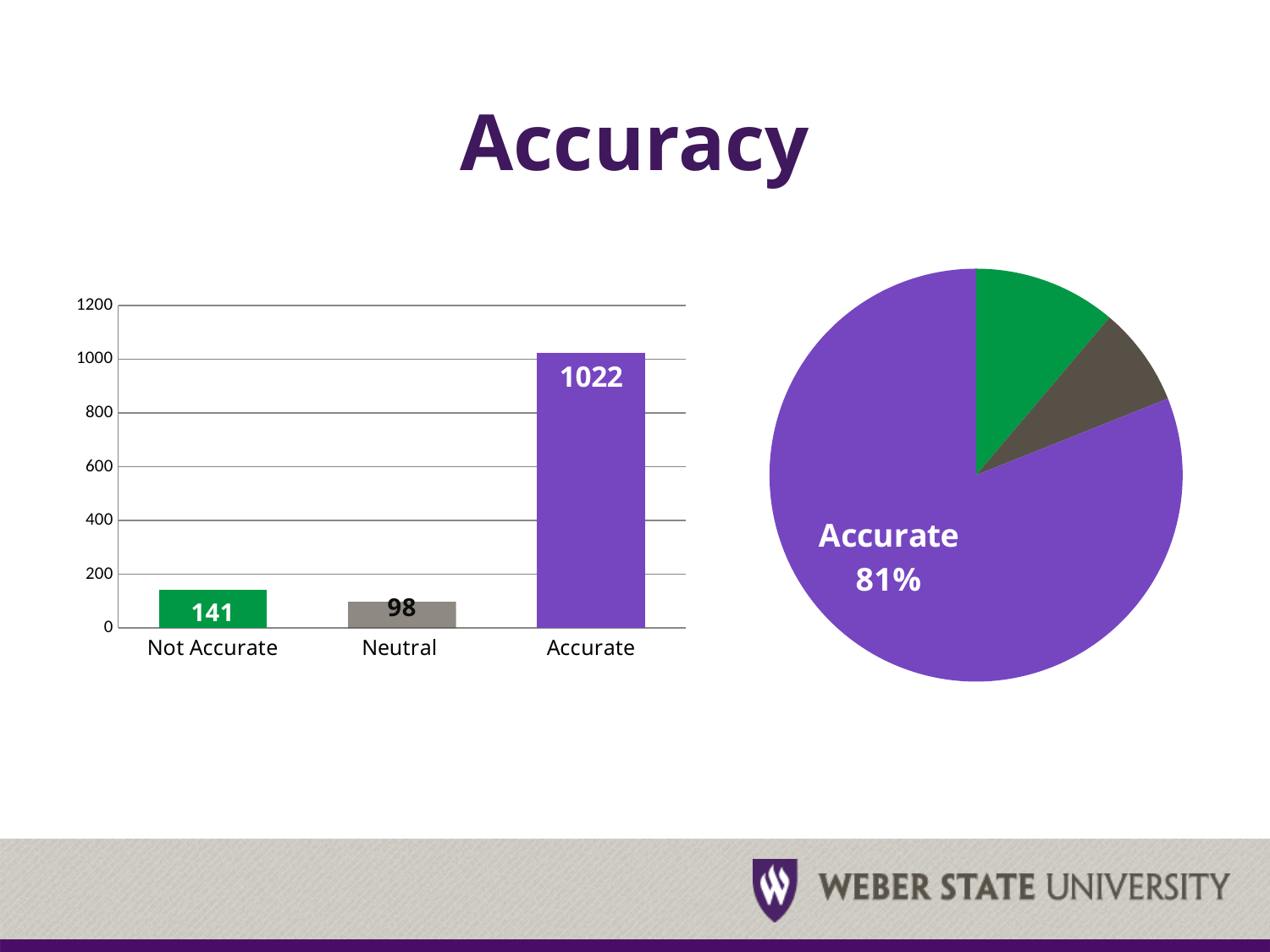
In the pie chart on the right, what share does the Accurate slice represent? 81% In the bar chart on the left, what is the value for Accurate? 1022 In the bar chart on the left, what is the value for Not Accurate? 141 What kind of chart is on the left side of the slide? bar chart In the bar chart on the left, what is the difference between the Accurate and Not Accurate values? 881 In the bar chart on the left, which category has the lowest value? Neutral In the bar chart on the left, is the value for Accurate greater or less than 1000? greater In the bar chart on the left, which category has the highest value? Accurate In the bar chart on the left, what is the difference between the Not Accurate and Neutral values? 43 How many categories are shown in the bar chart on the left? 3 In the bar chart on the left, what is the value for Neutral? 98 In the bar chart on the left, which is larger, Not Accurate or Neutral? Not Accurate